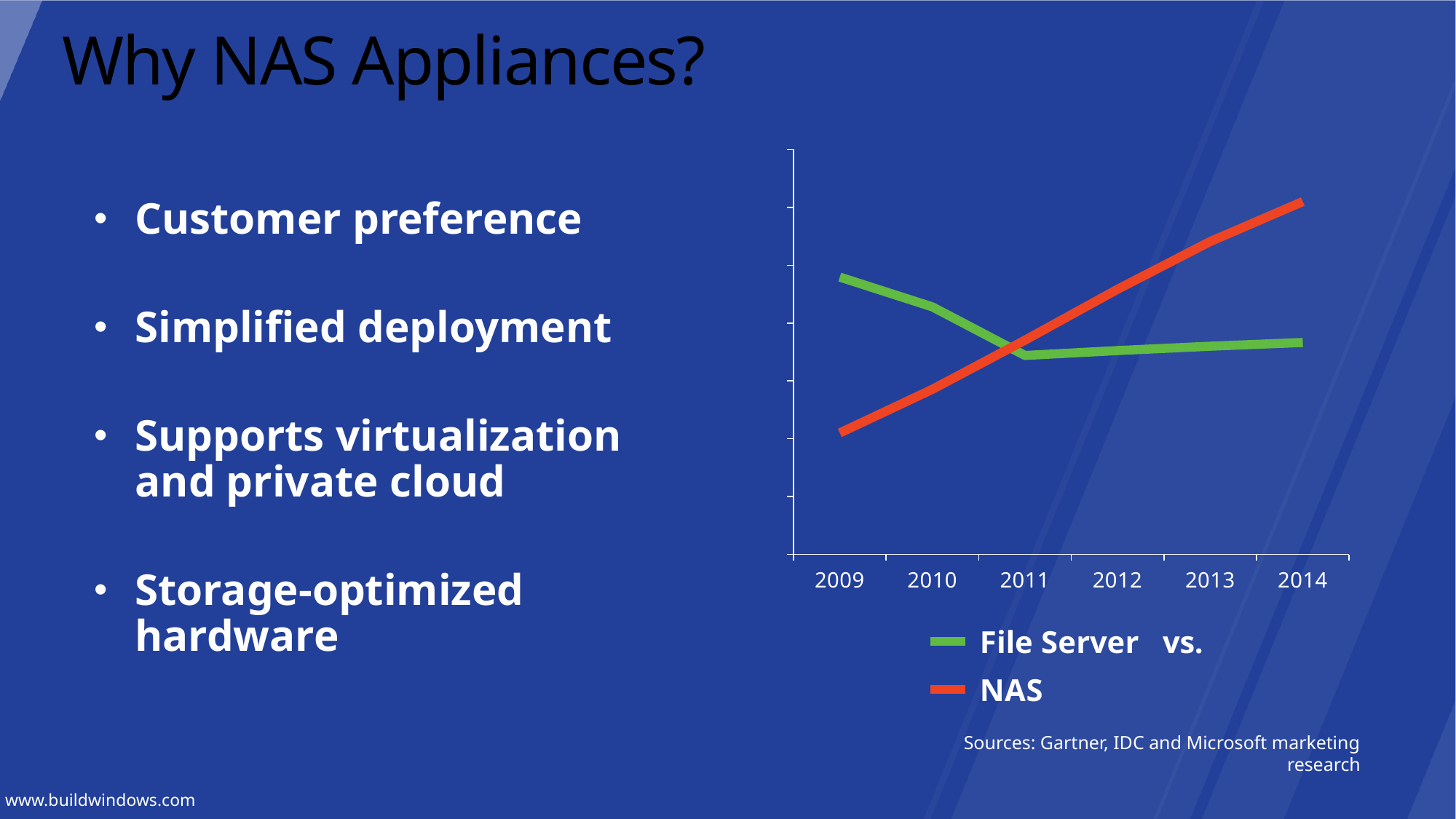
In which year is the NAS line at its lowest? 2009 In 2009, which series is higher, File Server or NAS? File Server Does the NAS line rise or fall from 2009 to 2014? rises In 2014, which series is higher, File Server or NAS? NAS How many years are shown on the x axis of the chart? 6 In which year is the File Server line at its highest? 2009 What is the first year shown on the chart's x axis? 2009 In which year is the NAS line at its highest? 2014 How many series does the chart's legend list? 2 Which colour is used for the NAS line in the chart? red What kind of chart is shown on the slide? line chart Does the File Server line rise or fall from 2009 to 2011? falls